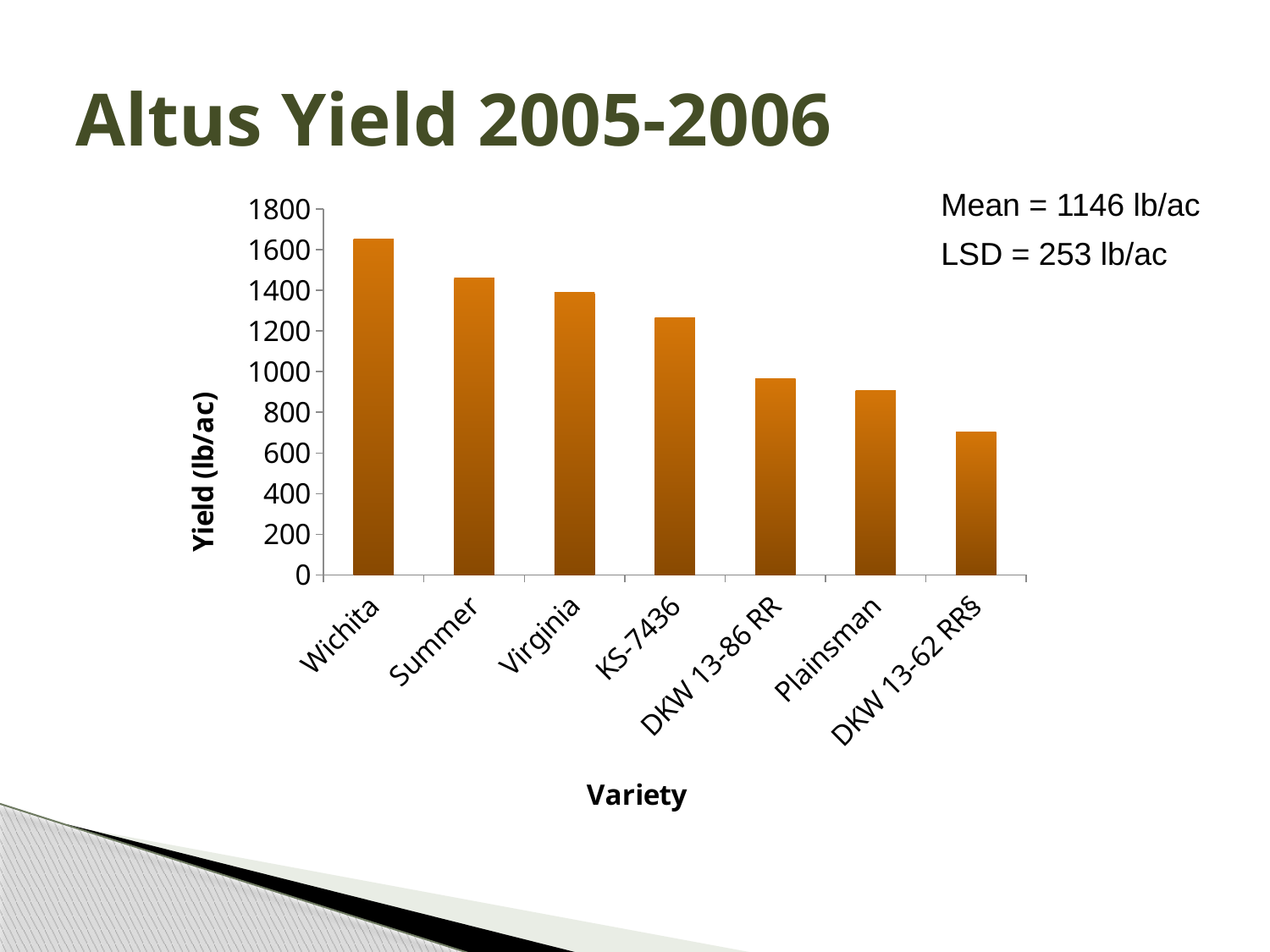
Is the yield for KS-7436 greater or less than 1200? greater Is the yield for DKW 13-62 RRs greater or less than 800? less Is the yield for Wichita greater or less than 1600? greater What is the label on the vertical axis of the chart? Yield (lb/ac) What kind of chart is shown on the slide? bar chart How many varieties are plotted in the chart? 7 Which variety has the highest yield? Wichita Do the yields rise or fall moving from left to right across the varieties? fall Which variety has the lowest yield? DKW 13-62 RRs Which has the larger yield, Summer or Plainsman? Summer